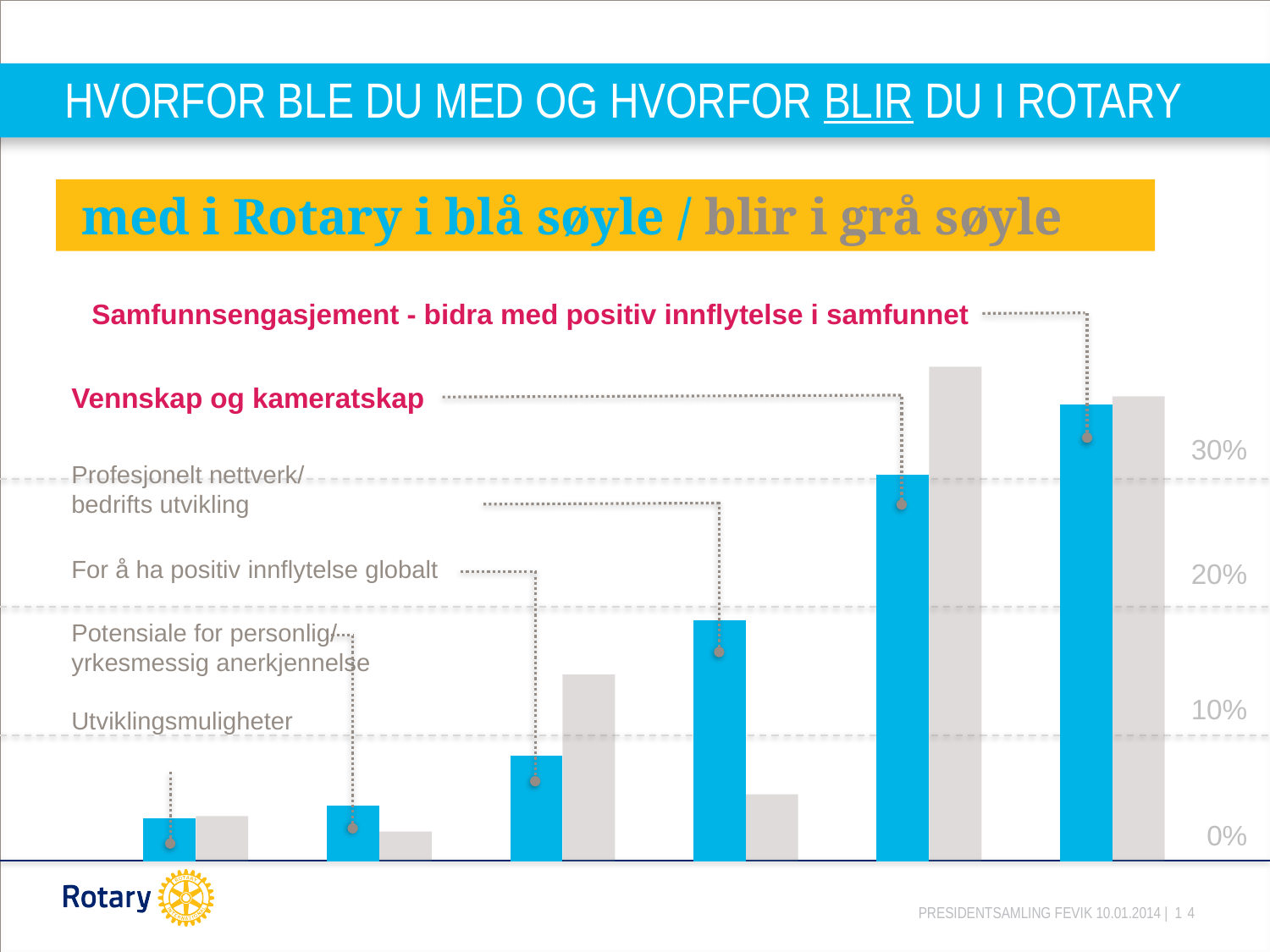
How many categories (reasons) are plotted in the chart? 6 Is the grey bar for 'For å ha positiv innflytelse globalt' greater or less than 10%? greater What kind of chart is shown on the slide? bar chart Which category has the highest grey bar? Vennskap og kameratskap Which category has the highest blue bar? Samfunnsengasjement - bidra med positiv innflytelse i samfunnet Is the blue bar for 'For å ha positiv innflytelse globalt' greater or less than 10%? less Is the blue bar for 'Samfunnsengasjement' greater or less than 30%? greater Which colour represents 'blir i Rotary' (staying in Rotary)? grey How many series does the chart show? 2 For 'Vennskap og kameratskap', which bar is larger, the blue or the grey? grey For 'Profesjonelt nettverk/bedrifts utvikling', which bar is larger, the blue or the grey? blue Which category has the lowest grey bar? Potensiale for personlig/yrkesmessig anerkjennelse